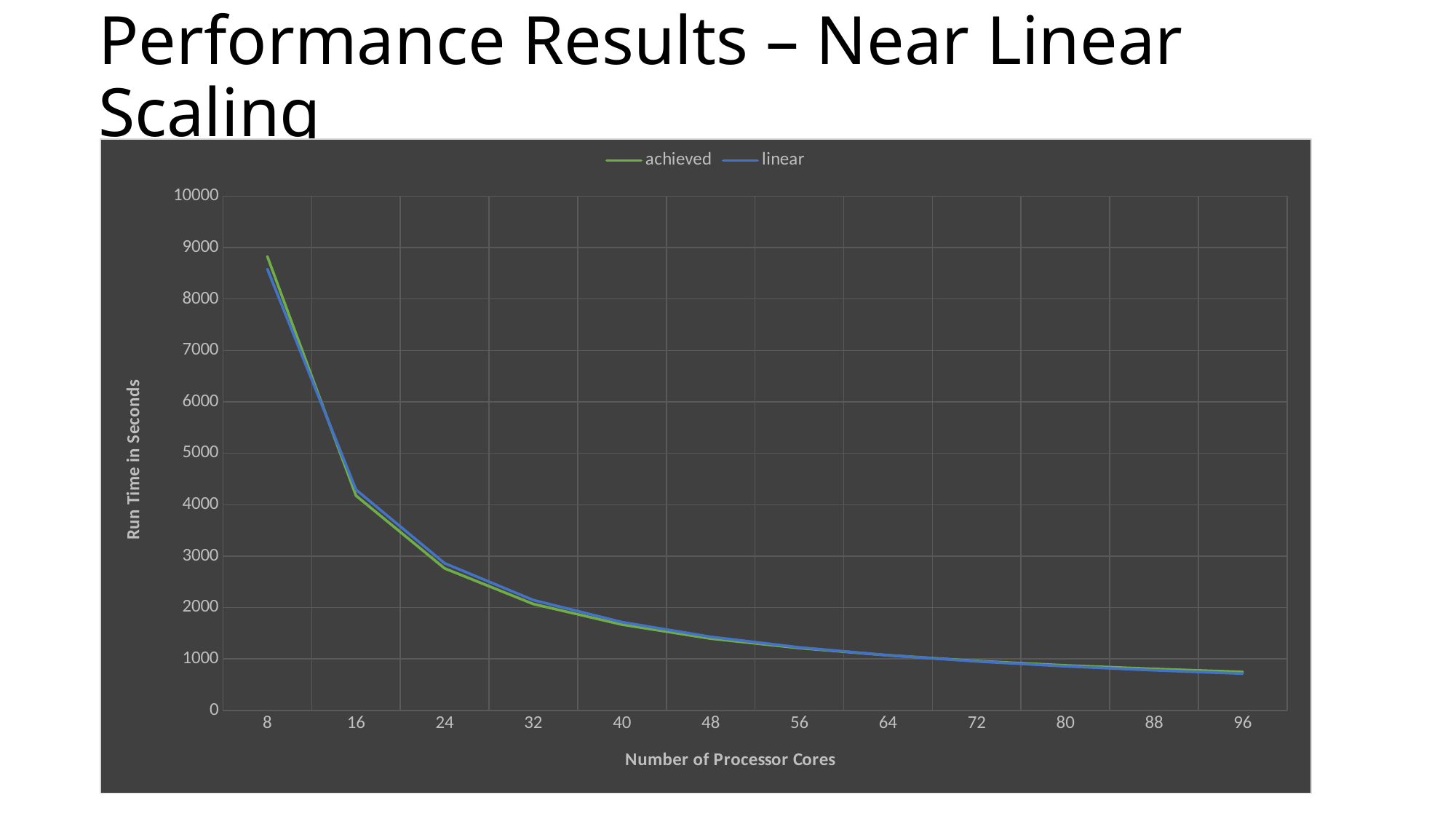
At which number of processor cores is the achieved run time highest? 8 What is the title of the x axis? Number of Processor Cores At which number of processor cores is the achieved run time lowest? 96 What are the names of the two series in the legend? achieved and linear Is the achieved run time at 96 cores greater or less than 1000 seconds? less Is the linear run time at 24 cores greater or less than 3000 seconds? less How many processor-core values are marked along the x axis? 12 How many series does the legend list? 2 Is the achieved run time at 8 cores greater or less than 8000 seconds? greater Do the run times rise or fall as the number of processor cores increases? fall What kind of chart is shown on the slide? line chart At 8 processor cores, which series has the higher run time, achieved or linear? achieved